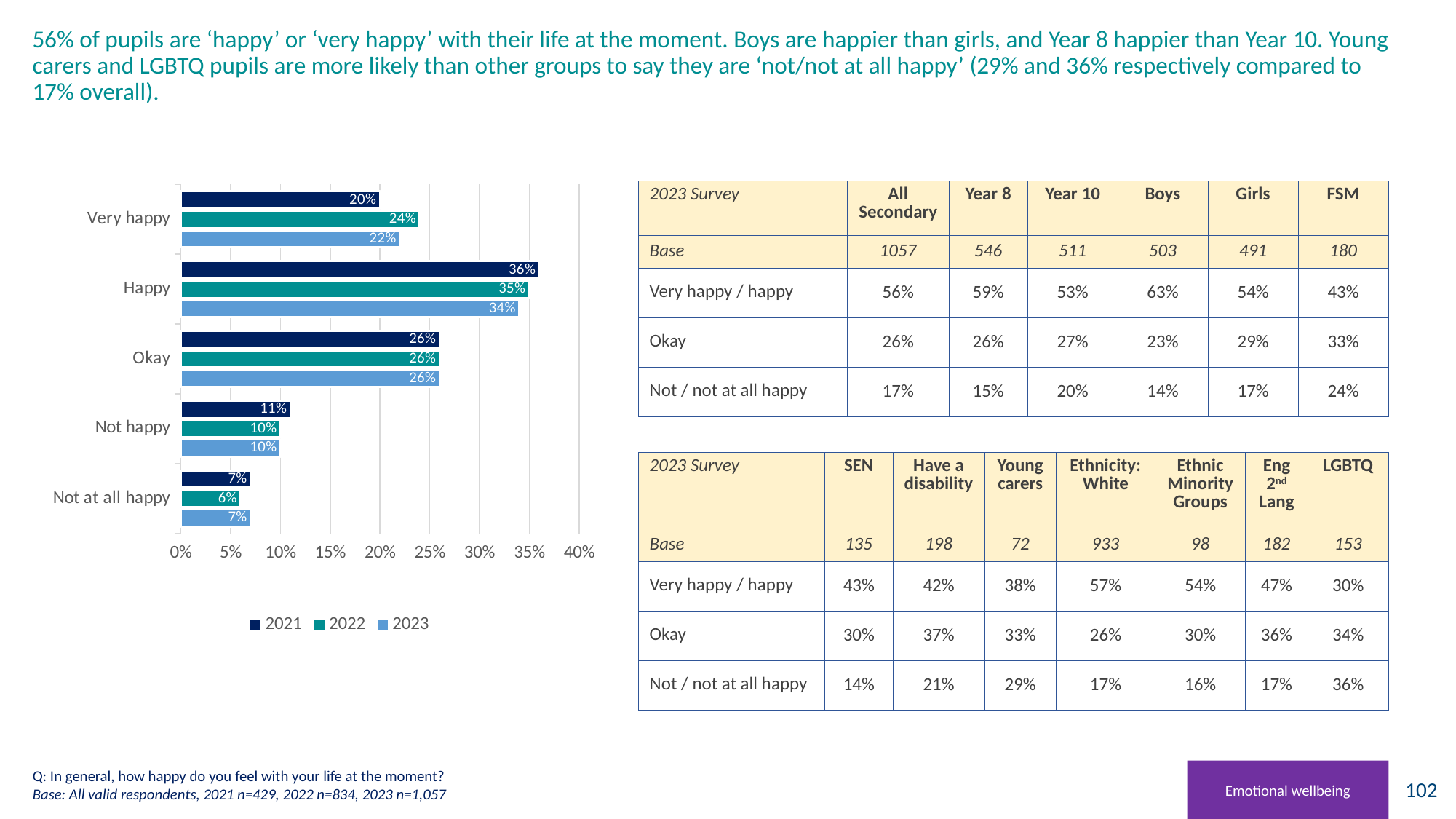
Which category has the highest value for the 2021 series? Happy What is the difference between the 2021 and 2023 values for 'Very happy'? 2% What percentage of pupils said they were 'Very happy' in 2022? 24% Which is larger: the 2021 value for 'Not happy' or the 2023 value for 'Not happy'? 2021 Which years are listed in the chart legend? 2021, 2022, 2023 What is the 'Okay' value for 2023? 26% What is the 2023 value for 'Happy'? 34% How many response categories are shown on the chart? 5 Which category has the lowest value for the 2022 series? Not at all happy What type of chart is shown on the slide? Bar chart How many series does the chart legend list? 3 What percentage of pupils said they were 'Not at all happy' in 2021? 7%